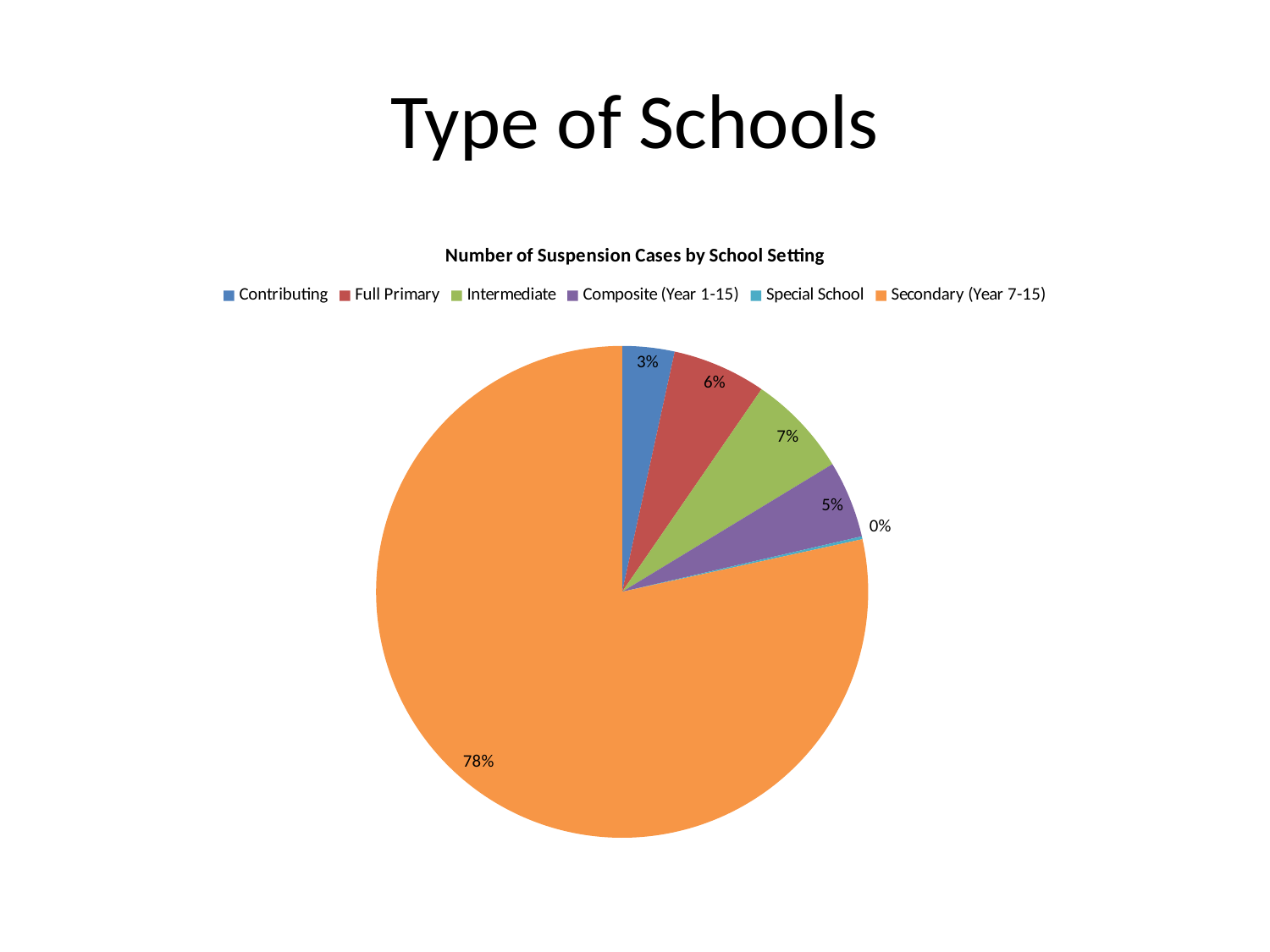
What share of suspension cases is from Composite (Year 1-15) schools? 5% Which school setting has the largest share of suspension cases? Secondary (Year 7-15) What share of suspension cases is from Contributing schools? 3% What is the title of the chart? Number of Suspension Cases by School Setting What share of suspension cases is from Full Primary schools? 6% How many categories does the legend list? 6 What is the difference in percentage points between the Intermediate and Contributing shares? 4 What kind of chart is shown on the slide? pie chart Which school setting has the smallest share of suspension cases? Special School